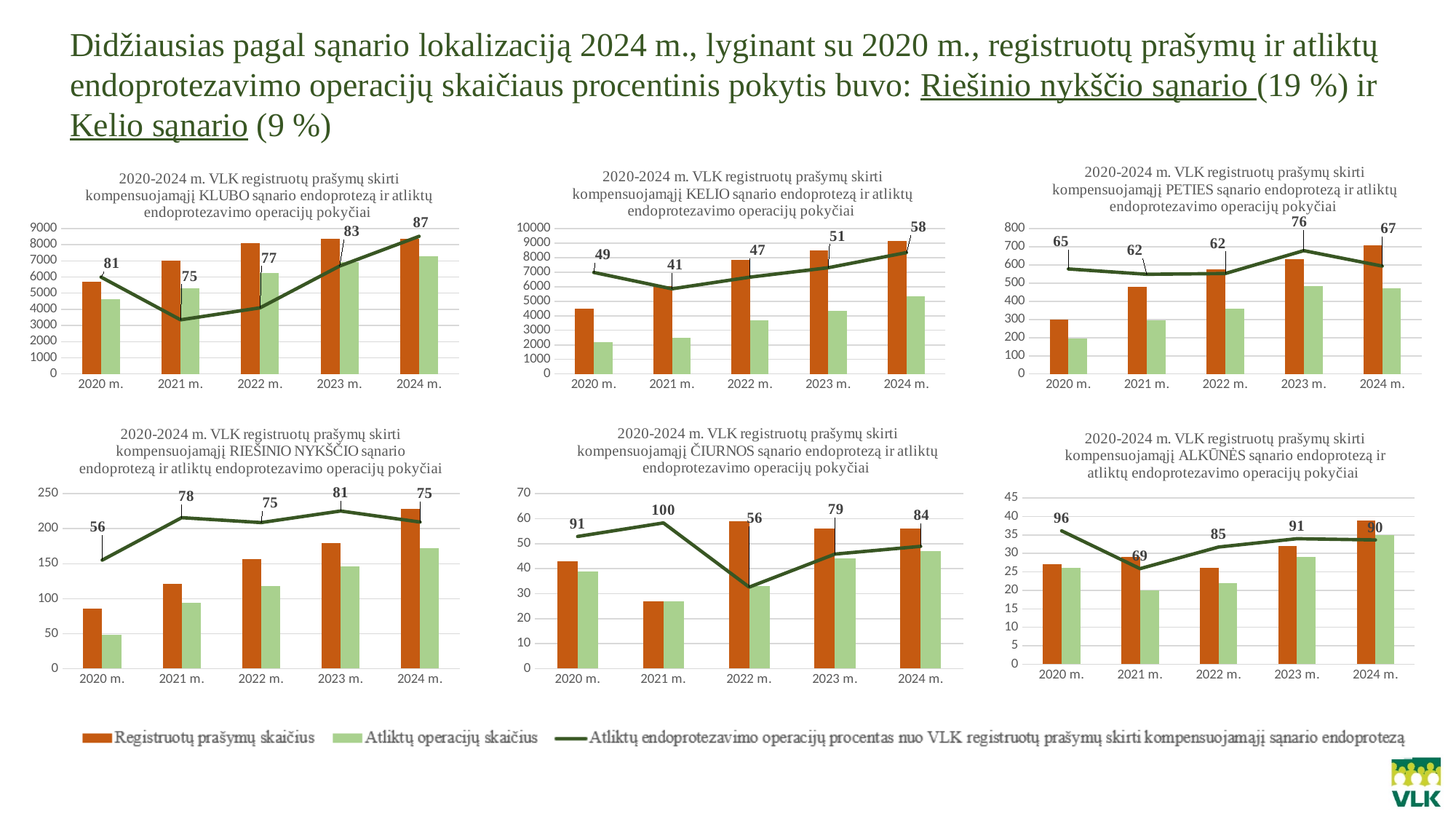
How many years are shown on the x axis of the PETIES chart? 5 In the KELIO chart, does the Registruotų prašymų skaičius series rise or fall from 2021 m. to 2024 m.? rise In the RIEŠINIO NYKŠČIO chart, which year has the lowest value on the line? 2020 m. In the ČIURNOS chart, which year has the highest value on the line? 2021 m. In the KELIO chart, is the line value for 2024 m. larger or smaller than the line value for 2020 m.? larger How many series does the shared legend at the bottom of the slide list? 3 In the KLUBO chart, what is the data label on the line for 2024 m.? 87 In the ALKŪNĖS chart, what is the difference between the line values for 2020 m. and 2021 m.? 27 In the ČIURNOS chart, is the value of Registruotų prašymų skaičius for 2021 m. greater or less than 30? less In the KELIO chart, what is the data label on the line for 2021 m.? 41 In the KLUBO chart, is the value of Registruotų prašymų skaičius for 2024 m. greater or less than 8000? greater In the PETIES chart, which year has the highest value on the line? 2023 m.